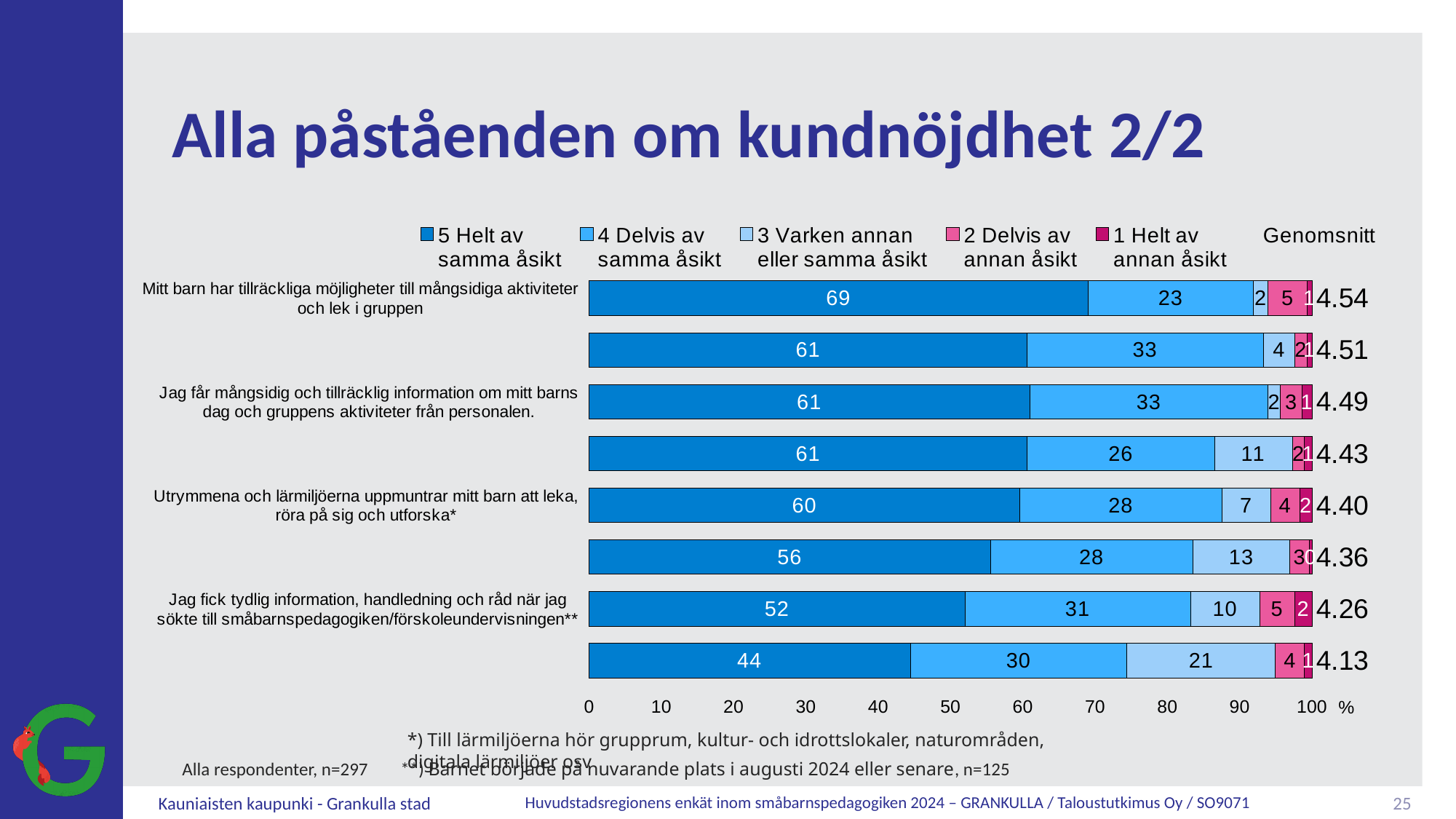
What percentage answered "3 Varken annan eller samma åsikt" for the statement "Jag fick tydlig information, handledning och råd när jag sökte till småbarnspedagogiken/förskoleundervisningen**"? 10 What is the difference in the "5 Helt av samma åsikt" share between "Mitt barn har tillräckliga möjligheter till mångsidiga aktiviteter och lek i gruppen" and "Jag fick tydlig information, handledning och råd när jag sökte till småbarnspedagogiken/förskoleundervisningen**"? 17 What is the Genomsnitt value shown for the bottom bar of the chart? 4.13 How many bars are plotted in the chart? 8 Is the "5 Helt av samma åsikt" share for "Utrymmena och lärmiljöerna uppmuntrar mitt barn att leka, röra på sig och utforska*" greater or less than 50? greater Which statement has the highest Genomsnitt value? Mitt barn har tillräckliga möjligheter till mångsidiga aktiviteter och lek i gruppen What is the Genomsnitt value for the statement "Utrymmena och lärmiljöerna uppmuntrar mitt barn att leka, röra på sig och utforska*"? 4.40 What kind of chart is shown on the slide? Stacked horizontal bar chart Which statement has a larger "4 Delvis av samma åsikt" share: "Jag får mångsidig och tillräcklig information om mitt barns dag och gruppens aktiviteter från personalen." or "Utrymmena och lärmiljöerna uppmuntrar mitt barn att leka, röra på sig och utforska*"? Jag får mångsidig och tillräcklig information om mitt barns dag och gruppens aktiviteter från personalen. What percentage of respondents answered "5 Helt av samma åsikt" for the statement "Mitt barn har tillräckliga möjligheter till mångsidiga aktiviteter och lek i gruppen"? 69 What is the total of the segments in the bar for "Mitt barn har tillräckliga möjligheter till mångsidiga aktiviteter och lek i gruppen"? 100 How many response categories does the legend list? 5